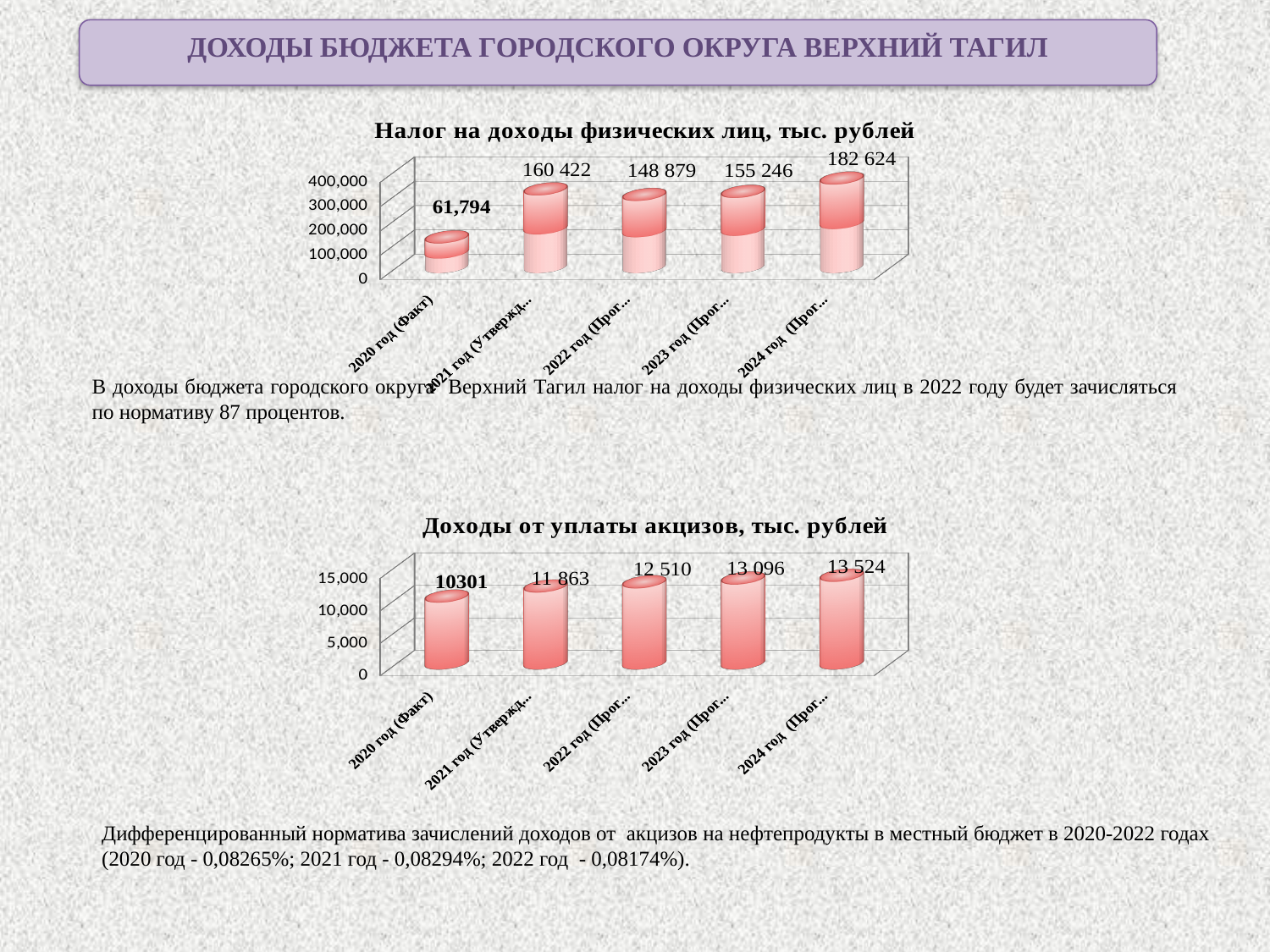
In the chart 'Налог на доходы физических лиц, тыс. рублей', which year has the lowest value? 2020 год (Факт) In the chart 'Налог на доходы физических лиц, тыс. рублей', what is the value for 2020 год (Факт)? 61,794 In the chart 'Налог на доходы физических лиц, тыс. рублей', what is the difference between the 2024 and 2021 values? 22 202 In the chart 'Доходы от уплаты акцизов, тыс. рублей', do the values rise or fall from 2020 to 2024? rise In the chart 'Налог на доходы физических лиц, тыс. рублей', how many bars are plotted? 5 In the chart 'Доходы от уплаты акцизов, тыс. рублей', what is the difference between the 2023 and 2022 values? 586 What type of chart is the bottom chart on the slide? bar chart In the chart 'Налог на доходы физических лиц, тыс. рублей', what is the value for 2024 год? 182 624 In the chart 'Доходы от уплаты акцизов, тыс. рублей', what is the value for 2020 год (Факт)? 10301 In the chart 'Налог на доходы физических лиц, тыс. рублей', which year has the highest value? 2024 год In the chart 'Доходы от уплаты акцизов, тыс. рублей', which is larger, the value for 2021 год or 2023 год? 2023 год In the chart 'Доходы от уплаты акцизов, тыс. рублей', what is the value for 2022 год? 12 510